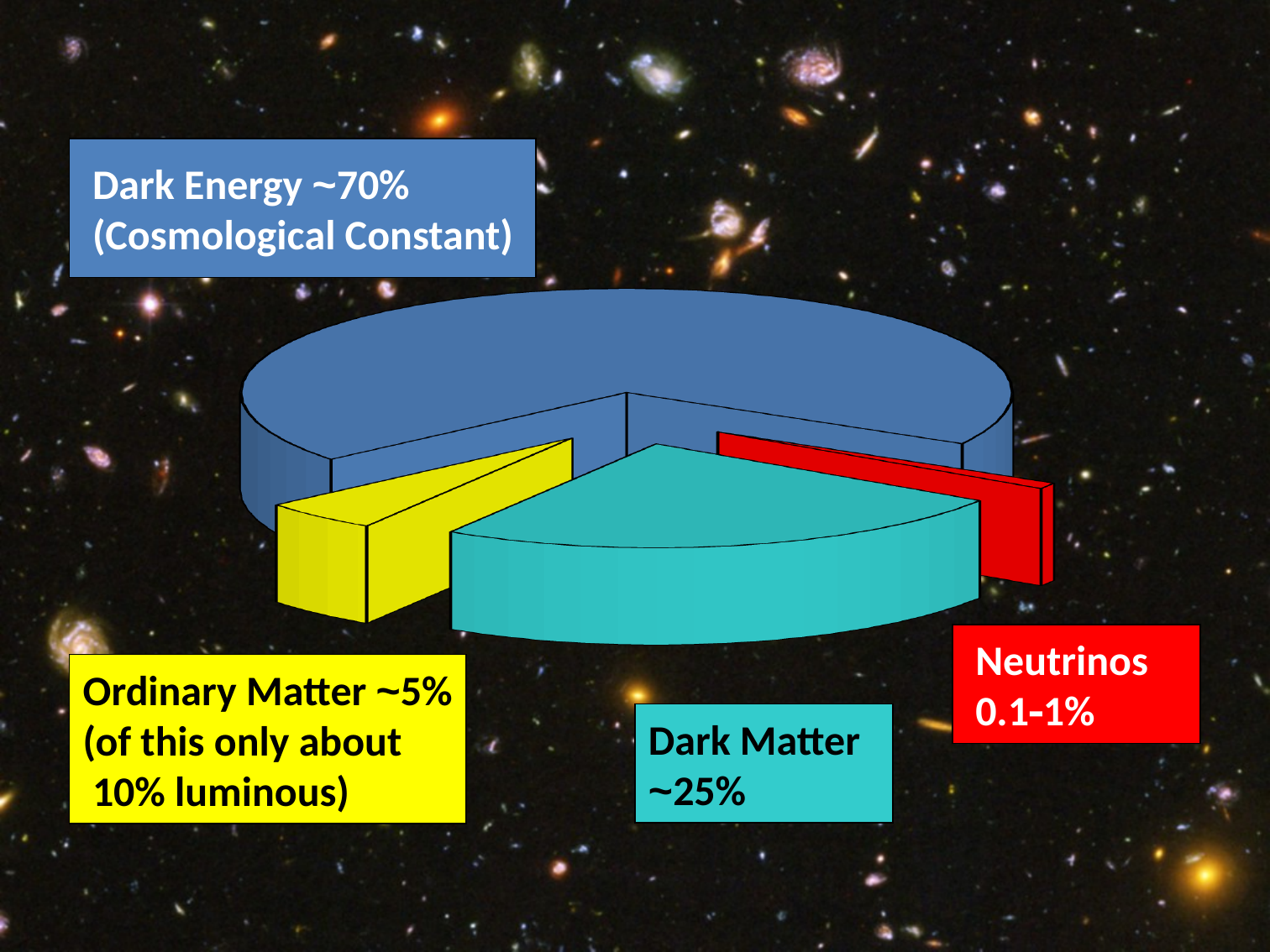
What percentage range is shown for Neutrinos? 0.1-1% What percentage label is shown for Dark Matter? ~25% What kind of chart is shown on the slide? pie chart How many slices does the pie chart have? 4 What colour is the Dark Matter slice of the pie chart? cyan What percentage label is shown for Dark Energy? ~70% Which is larger, the Ordinary Matter slice or the Neutrinos slice? Ordinary Matter What is written in parentheses under the Dark Energy label? Cosmological Constant Which component has the largest slice of the pie chart? Dark Energy Which is larger, the Dark Matter slice or the Ordinary Matter slice? Dark Matter What percentage label is shown for Ordinary Matter? ~5% Which component has the smallest slice of the pie chart? Neutrinos